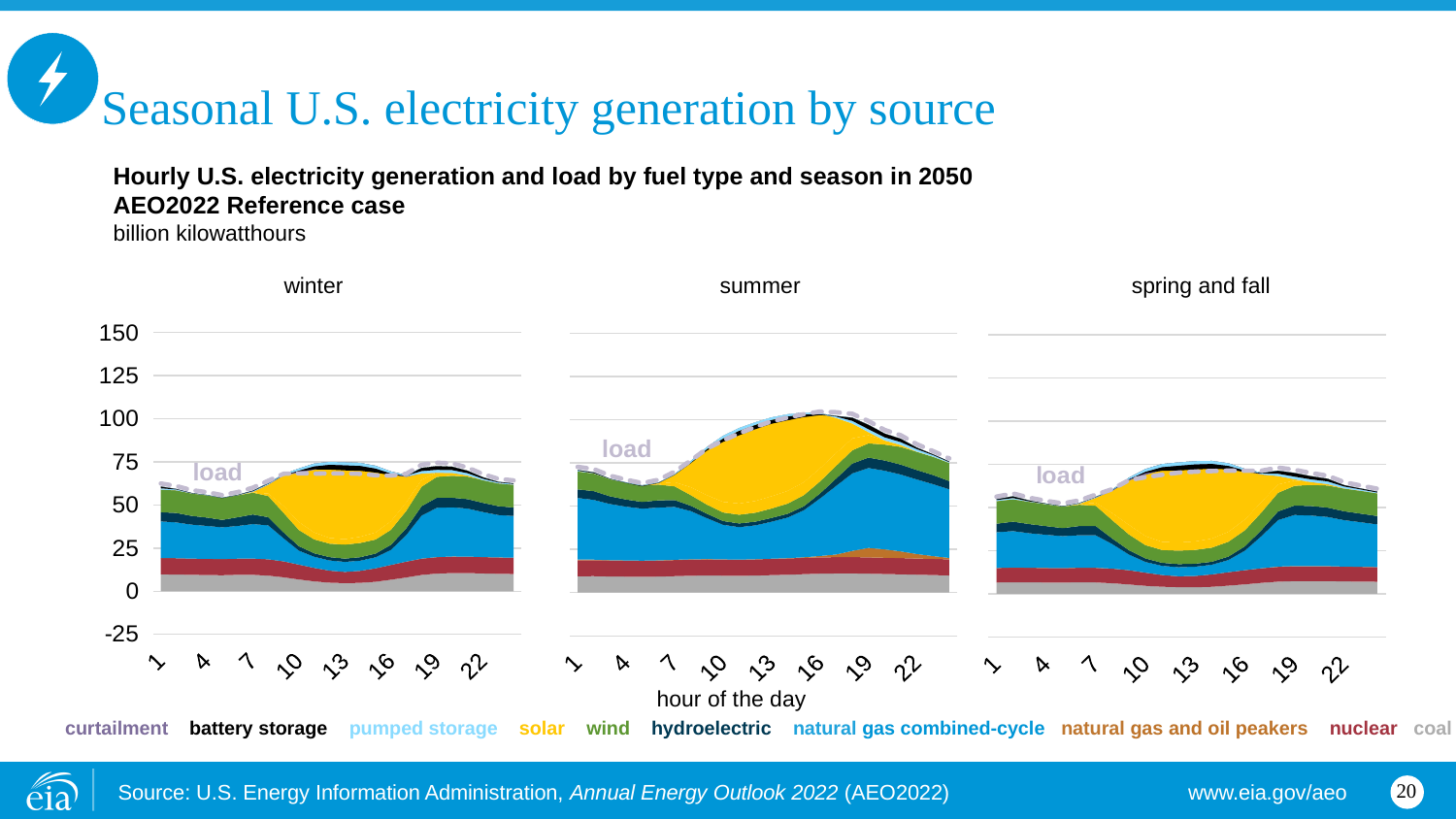
How many fuel-type series does the legend list? 10 In the summer chart, does total generation rise or fall between hour 7 and hour 13? rise In the summer chart, is the peak total generation around hour 13 greater or less than 75? greater Which season panel shows the lowest total generation at hour 1? spring and fall What unit is the y axis measured in? billion kilowatthours What kind of chart is used for the winter panel? stacked area chart Which season panel shows the highest peak total generation? summer In the winter chart, is the total generation at hour 13 larger or smaller than at hour 1? larger In the winter chart, is the peak total generation greater or less than 100? less What is the label on the shared x axis? hour of the day How many season panels are shown on the slide? 3 In the spring and fall chart, is the total generation at hour 1 greater or less than 75? less